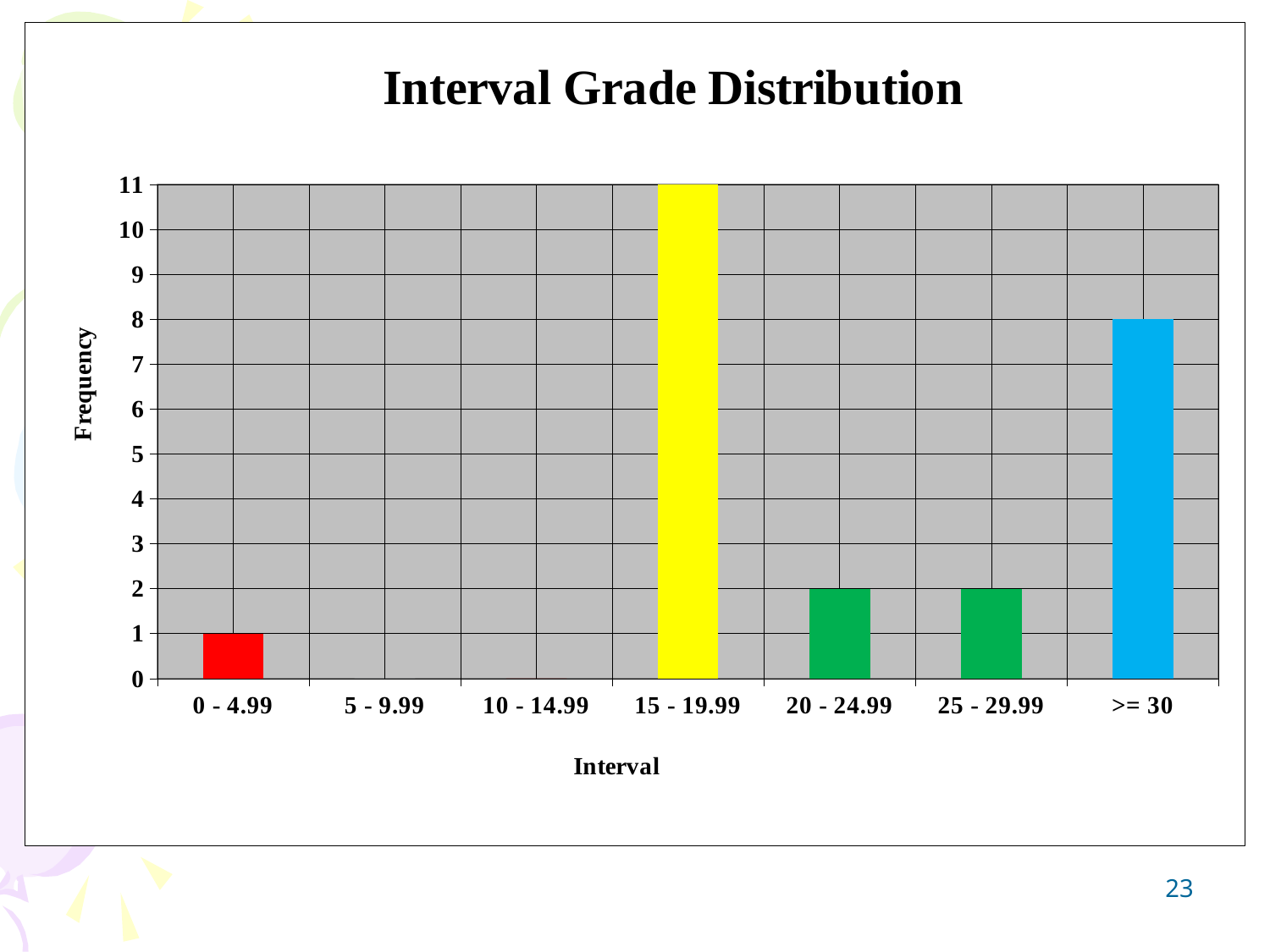
What is the title of the chart? Interval Grade Distribution Is the frequency for the >= 30 interval greater or less than 5? greater What is the difference in frequency between the 15 - 19.99 interval and the >= 30 interval? 3 How many intervals are shown on the x axis? 7 What is the frequency for the 15 - 19.99 interval? 11 What is the label of the y axis? Frequency What is the frequency for the >= 30 interval? 8 What is the frequency for the 20 - 24.99 interval? 2 What is the frequency for the 0 - 4.99 interval? 1 Which interval has the highest frequency? 15 - 19.99 Which has a higher frequency, the 0 - 4.99 interval or the 25 - 29.99 interval? 25 - 29.99 What kind of chart is shown on the slide? bar chart